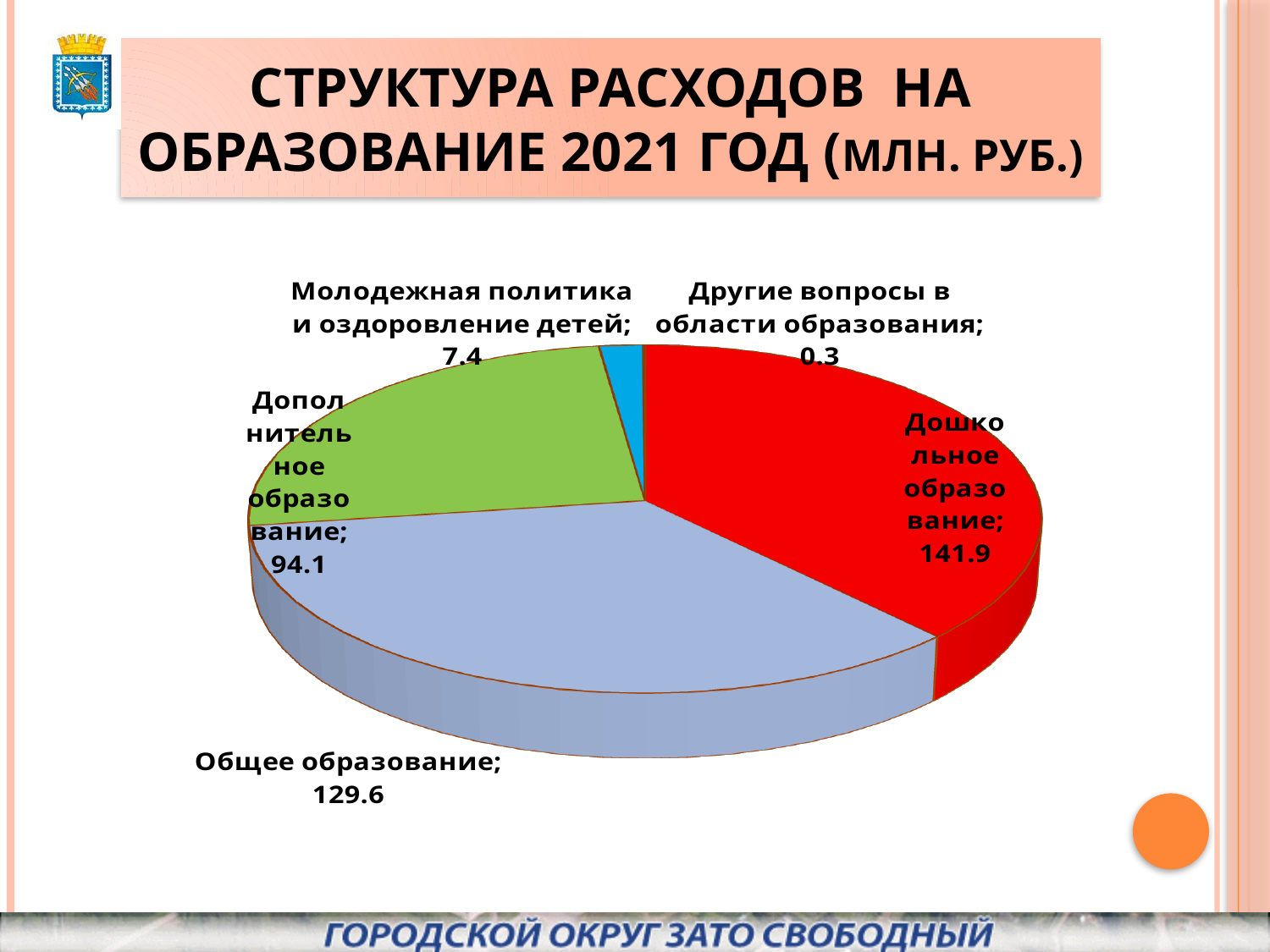
What type of chart is shown on the slide? Pie chart What is the difference between Дошкольное образование and Общее образование? 12.3 What is the value for Молодежная политика и оздоровление детей? 7.4 What is the value for Дошкольное образование? 141.9 What is the total of all slices in the pie chart? 373.3 How many slices does the pie chart have? 5 What is the difference between Общее образование and Дополнительное образование? 35.5 Which is larger, Дополнительное образование or Молодежная политика и оздоровление детей? Дополнительное образование Which category has the largest value? Дошкольное образование What is the value for Общее образование? 129.6 Which category has the smallest value? Другие вопросы в области образования What is the value for Дополнительное образование? 94.1